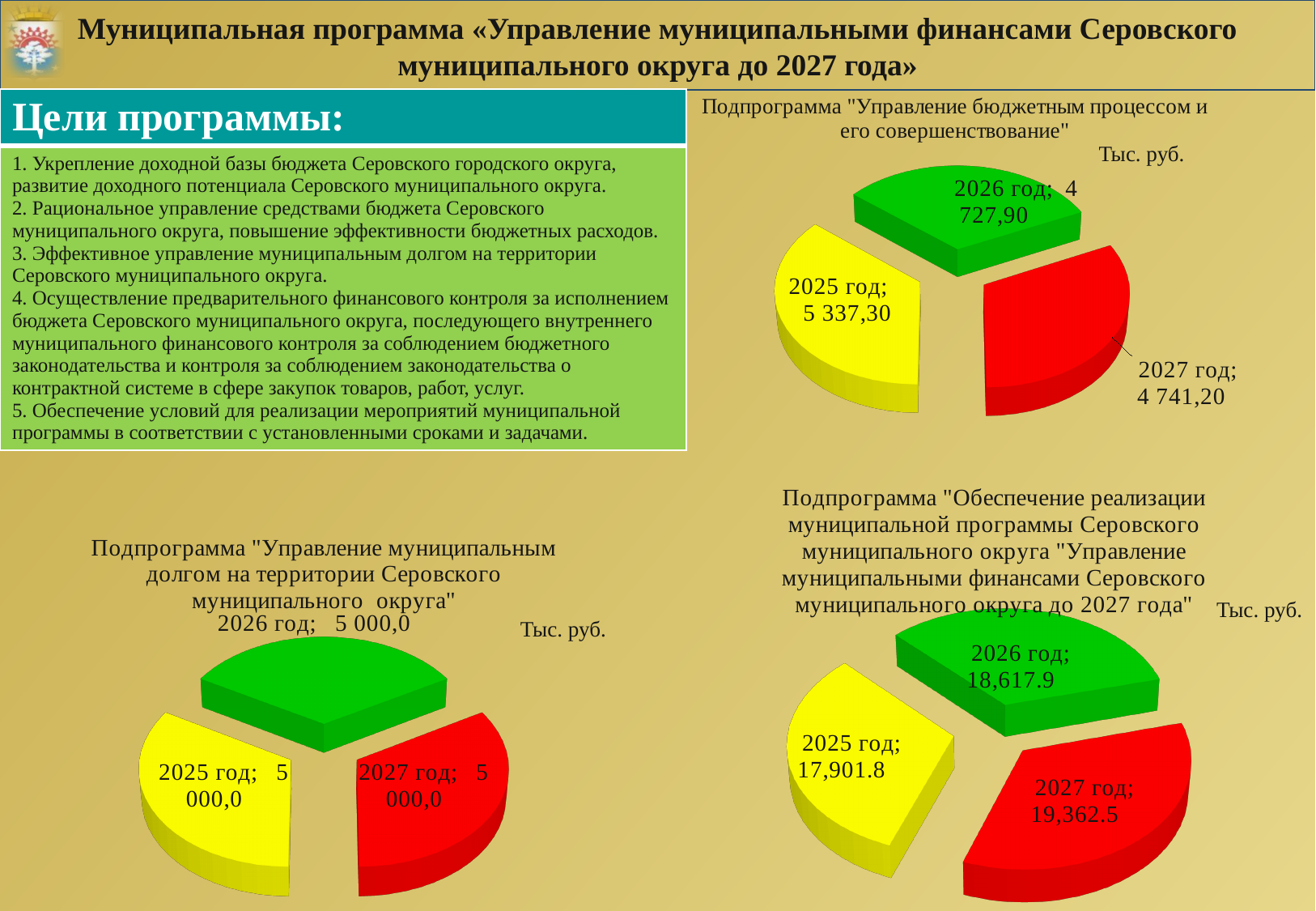
In the pie chart titled "Подпрограмма "Управление бюджетным процессом и его совершенствование"", what is the difference between the values for 2025 год and 2027 год? 596,10 In the bottom-right pie chart titled "Подпрограмма "Обеспечение реализации муниципальной программы..."", what is the value for 2026 год? 18,617.9 What kind of chart is the bottom-left chart about "Управление муниципальным долгом"? Pie chart In the pie chart titled "Подпрограмма "Управление бюджетным процессом и его совершенствование"", which year has the largest value? 2025 год In the bottom-right pie chart titled "Подпрограмма "Обеспечение реализации муниципальной программы..."", what is the difference between the values for 2027 год and 2025 год? 1,460.7 In the pie chart titled "Подпрограмма "Управление бюджетным процессом и его совершенствование"", which year has the smallest value? 2026 год In the bottom-right pie chart titled "Подпрограмма "Обеспечение реализации муниципальной программы..."", which year has the largest value? 2027 год In the pie chart titled "Подпрограмма "Управление бюджетным процессом и его совершенствование"", which is larger, the value for 2026 год or 2027 год? 2027 год In the bottom-left pie chart titled "Подпрограмма "Управление муниципальным долгом на территории Серовского муниципального округа"", what is the value for 2027 год? 5 000,0 In the pie chart titled "Подпрограмма "Управление бюджетным процессом и его совершенствование"", what is the value for 2025 год? 5 337,30 How many slices does the bottom-left pie chart about "Управление муниципальным долгом" have? 3 What unit is shown next to the top-right pie chart about "Управление бюджетным процессом"? Тыс. руб.